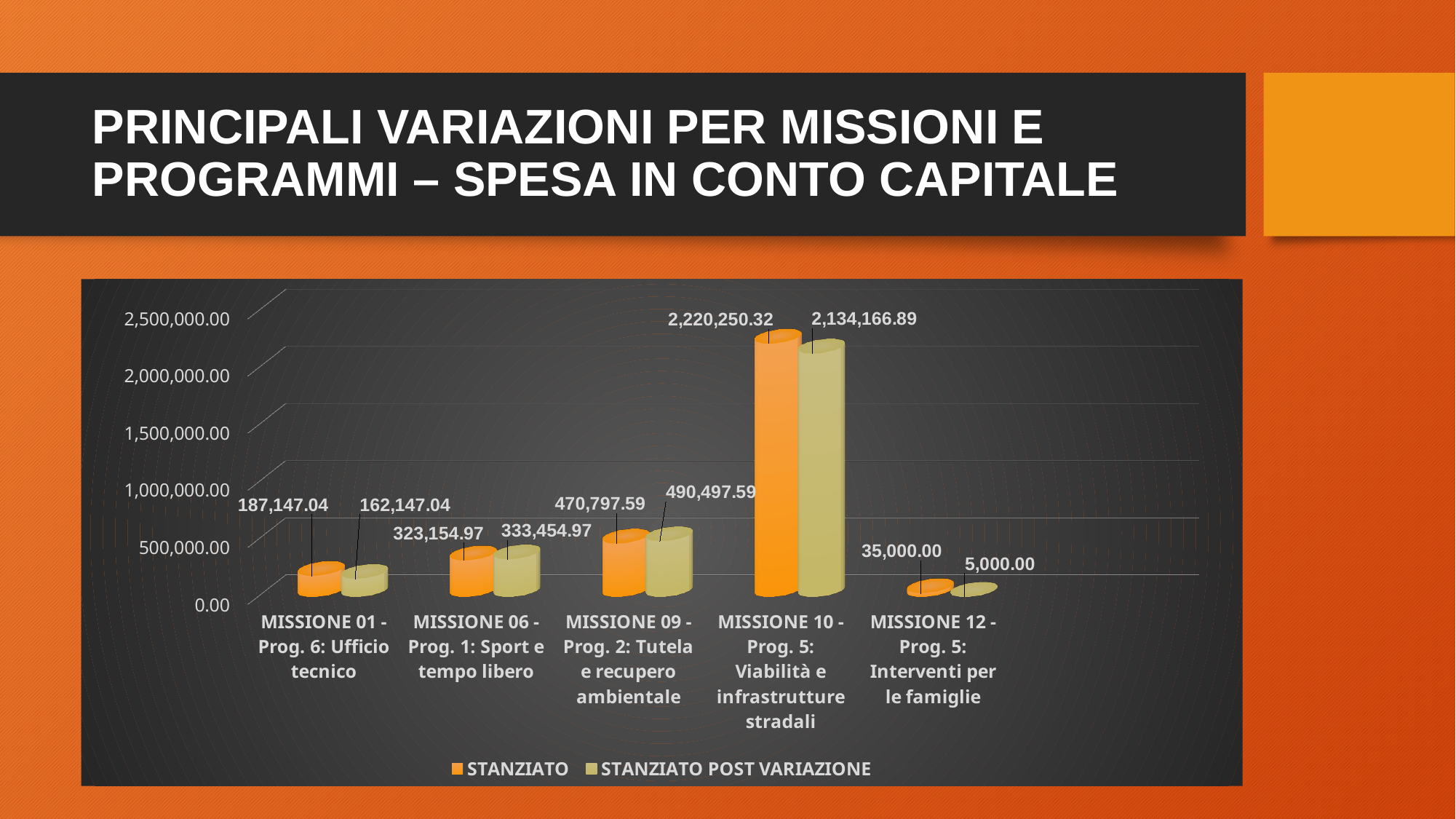
Which category has the lowest STANZIATO POST VARIAZIONE value? MISSIONE 12 - Prog. 5: Interventi per le famiglie What is the STANZIATO value for MISSIONE 10 - Prog. 5: Viabilità e infrastrutture stradali? 2,220,250.32 How many categories are shown on the x axis of the chart? 5 What is the STANZIATO POST VARIAZIONE value for MISSIONE 12 - Prog. 5: Interventi per le famiglie? 5,000.00 What is the STANZIATO POST VARIAZIONE value for MISSIONE 06 - Prog. 1: Sport e tempo libero? 333,454.97 Which category has the highest STANZIATO value? MISSIONE 10 - Prog. 5: Viabilità e infrastrutture stradali How many series does the chart legend list? 2 What is the difference between the STANZIATO and STANZIATO POST VARIAZIONE values for MISSIONE 10 - Prog. 5: Viabilità e infrastrutture stradali? 86,083.43 For MISSIONE 09 - Prog. 2: Tutela e recupero ambientale, which is larger: STANZIATO or STANZIATO POST VARIAZIONE? STANZIATO POST VARIAZIONE What kind of chart is shown on the slide? Bar chart What is the difference between the STANZIATO and STANZIATO POST VARIAZIONE values for MISSIONE 01 - Prog. 6: Ufficio tecnico? 25,000.00 Is the STANZIATO value for MISSIONE 10 - Prog. 5: Viabilità e infrastrutture stradali greater or less than 2,000,000.00? greater